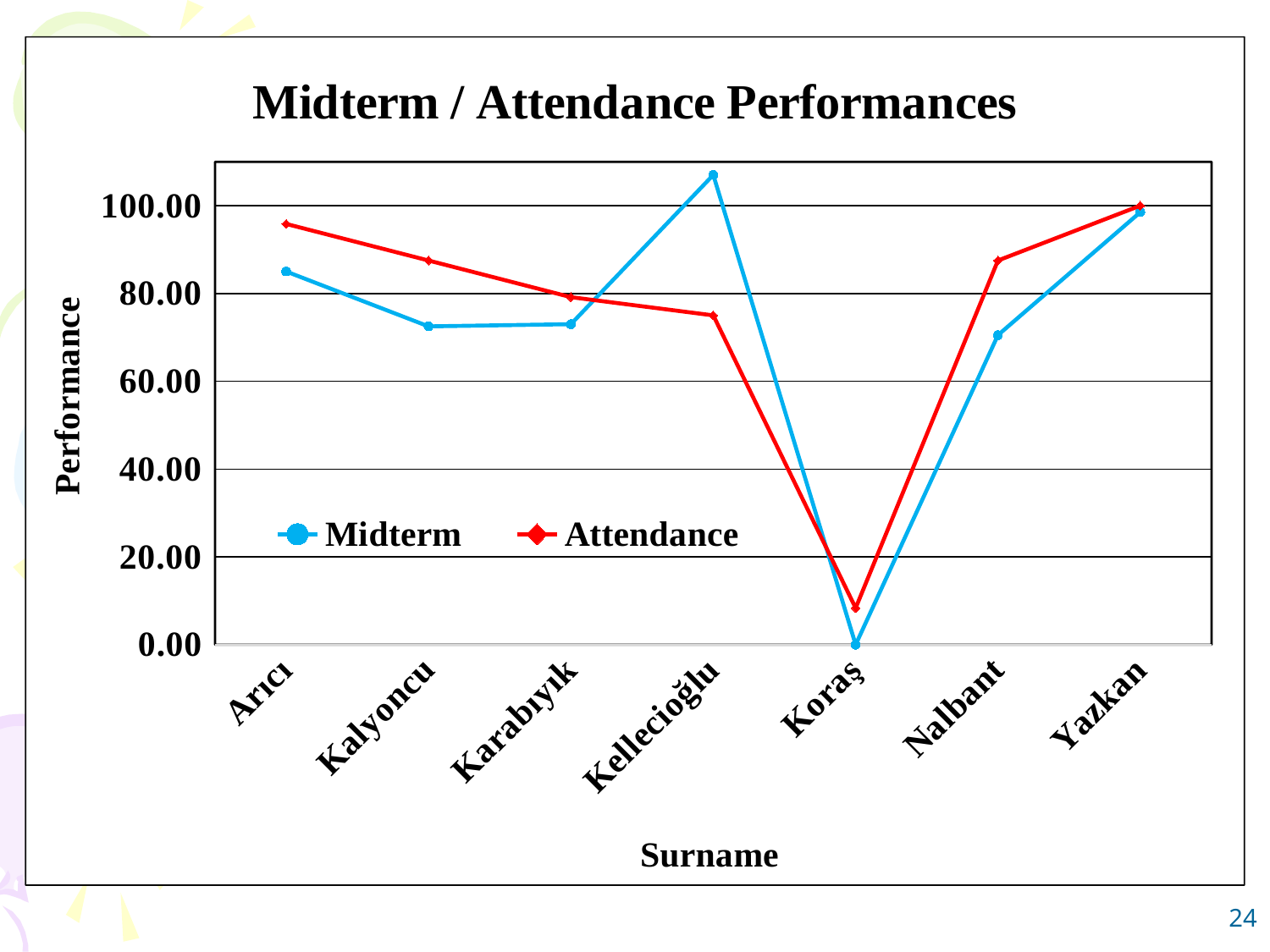
Is the Midterm value for Kellecioğlu greater or less than 100.00? greater Is the Attendance value for Koraş greater or less than 20.00? less How many surnames are plotted along the x axis? 7 What is the Midterm value for Koraş? 0.00 Which surname has the highest Midterm value? Kellecioğlu How many series does the legend list? 2 What is the title of the chart? Midterm / Attendance Performances What is the Attendance value for Yazkan? 100.00 For Arıcı, which is larger: the Midterm value or the Attendance value? Attendance Which surname has the lowest Attendance value? Koraş Is the Midterm value for Nalbant greater or less than 80.00? less What kind of chart is shown on the slide? line chart